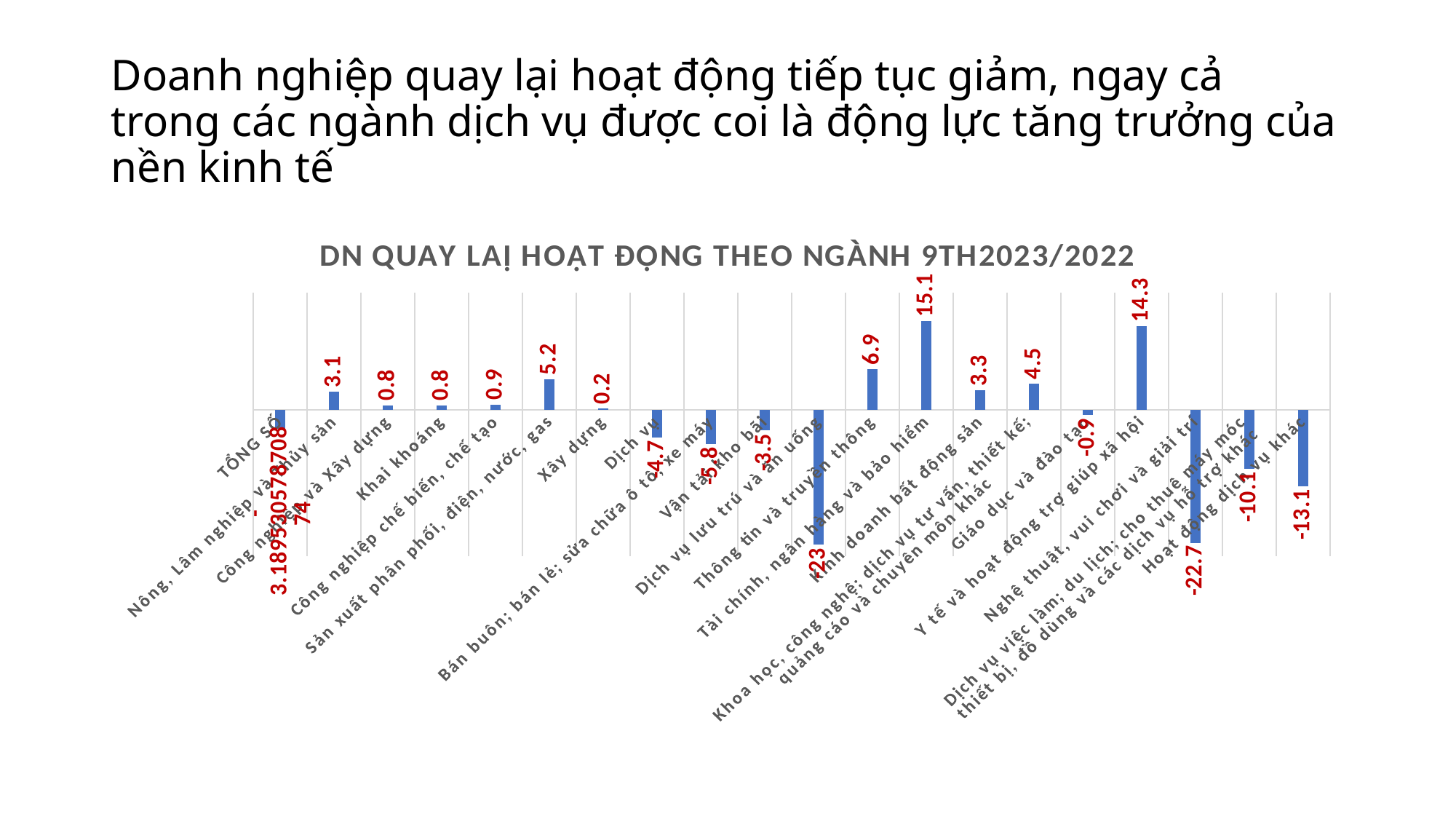
What type of chart is shown on the slide? bar chart What is the difference between the values for Tài chính, ngân hàng và bảo hiểm and Y tế và hoạt động trợ giúp xã hội? 0.8 What is the value for Tài chính, ngân hàng và bảo hiểm? 15.1 What is the value for Dịch vụ lưu trú và ăn uống? -23 What is the value for Giáo dục và đào tạo? -0.9 Which category has the lowest value? Dịch vụ lưu trú và ăn uống What is the title of the chart? DN QUAY LAỊ HOẠT ĐỌNG THEO NGÀNH 9TH2023/2022 Which is larger, the value for Thông tin và truyền thông or the value for Kinh doanh bất động sản? Thông tin và truyền thông Which category has the highest value? Tài chính, ngân hàng và bảo hiểm What is the value for Nghệ thuật, vui chơi và giải trí? -22.7 How many categories are plotted in the chart? 20 What is the value for Sản xuất phân phối, điện, nước, gas? 5.2